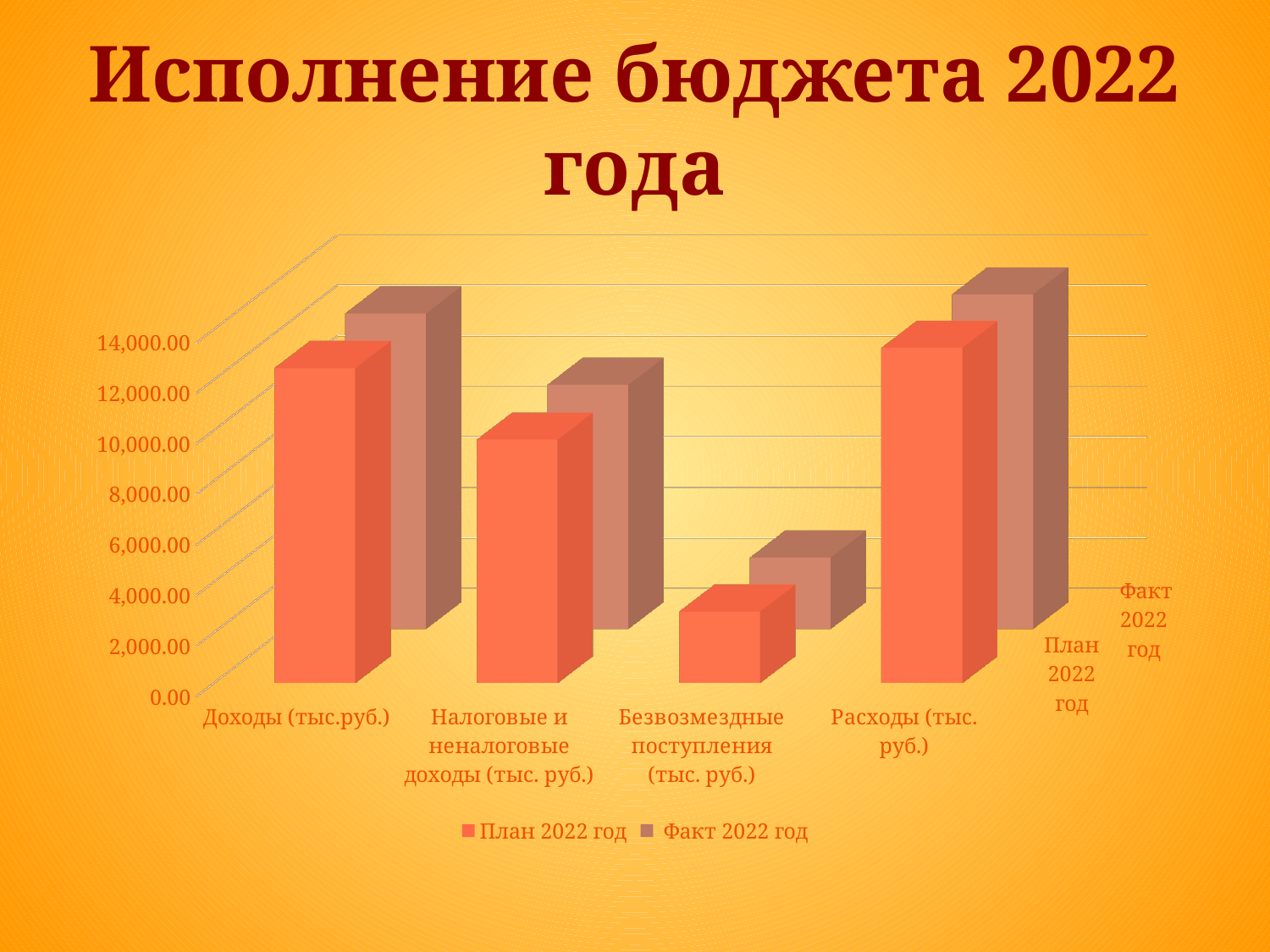
Which category has the lowest value for План 2022 год? Безвозмездные поступления (тыс. руб.) Is the План 2022 год value for Безвозмездные поступления (тыс. руб.) greater or less than 4,000.00? less How many series does the legend list? 2 Which category has the lowest value for Факт 2022 год? Безвозмездные поступления (тыс. руб.) How many categories are shown on the x axis? 4 What is the title of the chart on the slide? Исполнение бюджета 2022 года What are the two series named in the legend? План 2022 год and Факт 2022 год What kind of chart is shown on the slide? bar chart Is the План 2022 год value for Налоговые и неналоговые доходы (тыс. руб.) greater or less than 8,000.00? greater